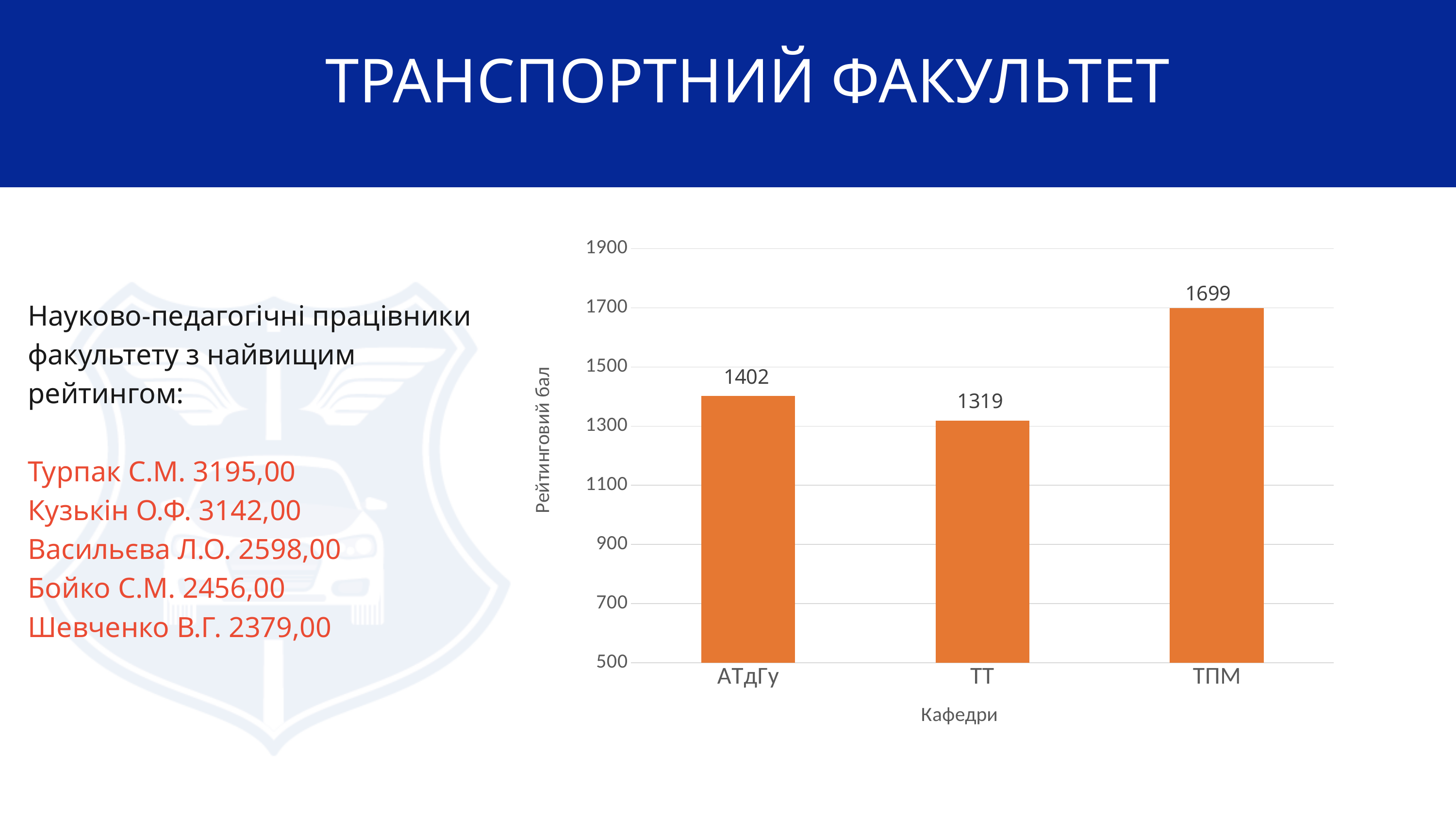
How many departments are shown on the chart? 3 What is the label of the x axis of the chart? Кафедри What is the rating score for the ТТ department? 1319 Which department has a higher rating score, АТдГу or ТТ? АТдГу What is the difference between the rating scores of АТдГу and ТТ? 83 Which department has the lowest rating score? ТТ Which department has the highest rating score? ТПМ What is the difference between the rating scores of ТПМ and АТдГу? 297 What is the rating score for the ТПМ department? 1699 Is the value for ТПМ greater or less than 1500? greater What is the rating score (Рейтинговий бал) for the АТдГу department? 1402 What kind of chart is shown on the slide? Bar chart